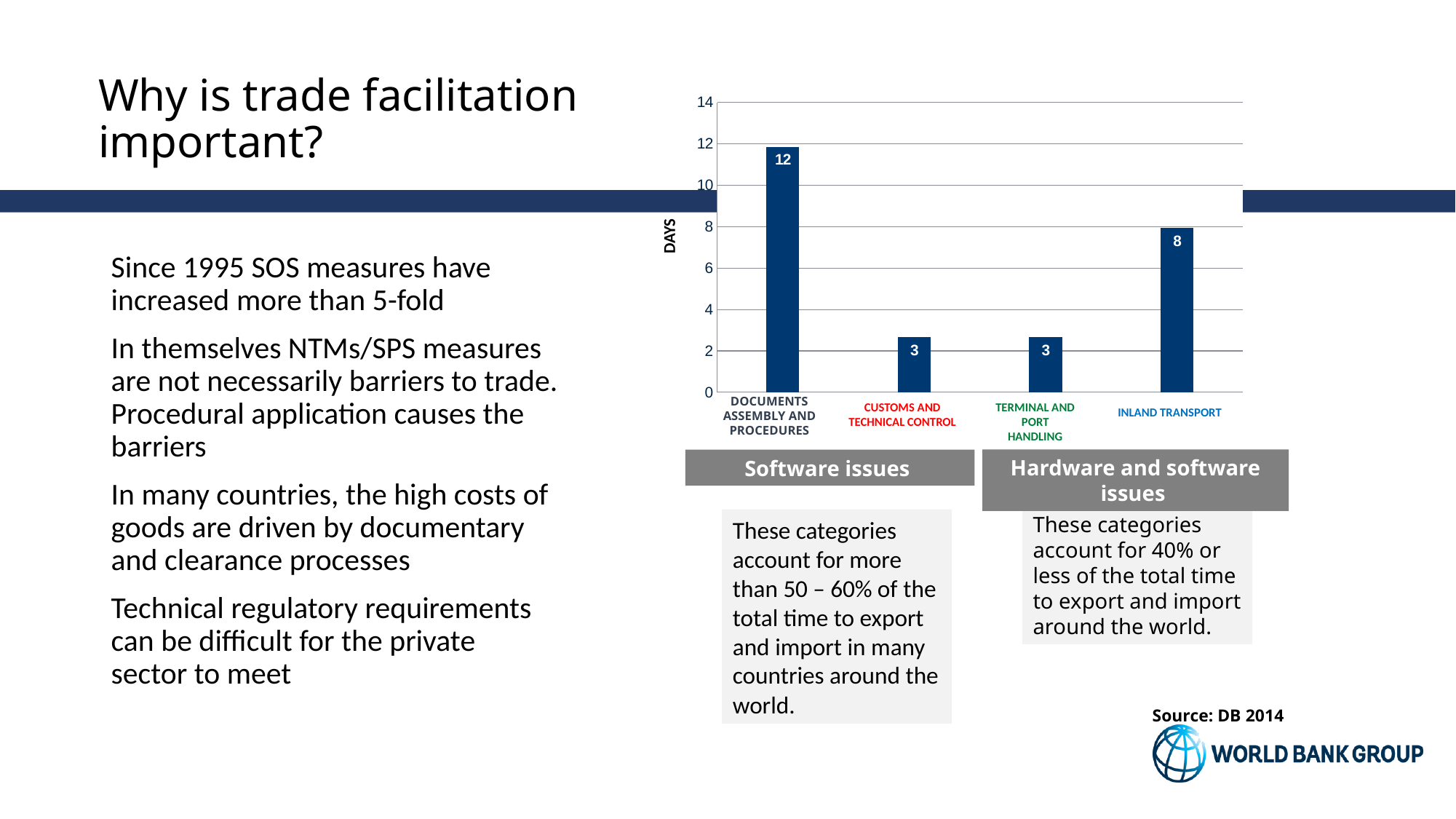
What kind of chart is shown on the slide? bar chart How many days are shown for Documents Assembly and Procedures? 12 Is the value for Documents Assembly and Procedures greater or less than 10? greater What is the label on the vertical axis of the chart? DAYS How many categories are plotted on the chart? 4 What is the total of the values for Customs and Technical Control and Terminal and Port Handling? 6 Which category has the highest number of days? Documents Assembly and Procedures What is the source cited for the chart? DB 2014 What is the difference in days between Documents Assembly and Procedures and Inland Transport? 4 What is the value for Customs and Technical Control? 3 What is the value for Inland Transport? 8 Which is larger, the value for Inland Transport or the value for Terminal and Port Handling? Inland Transport